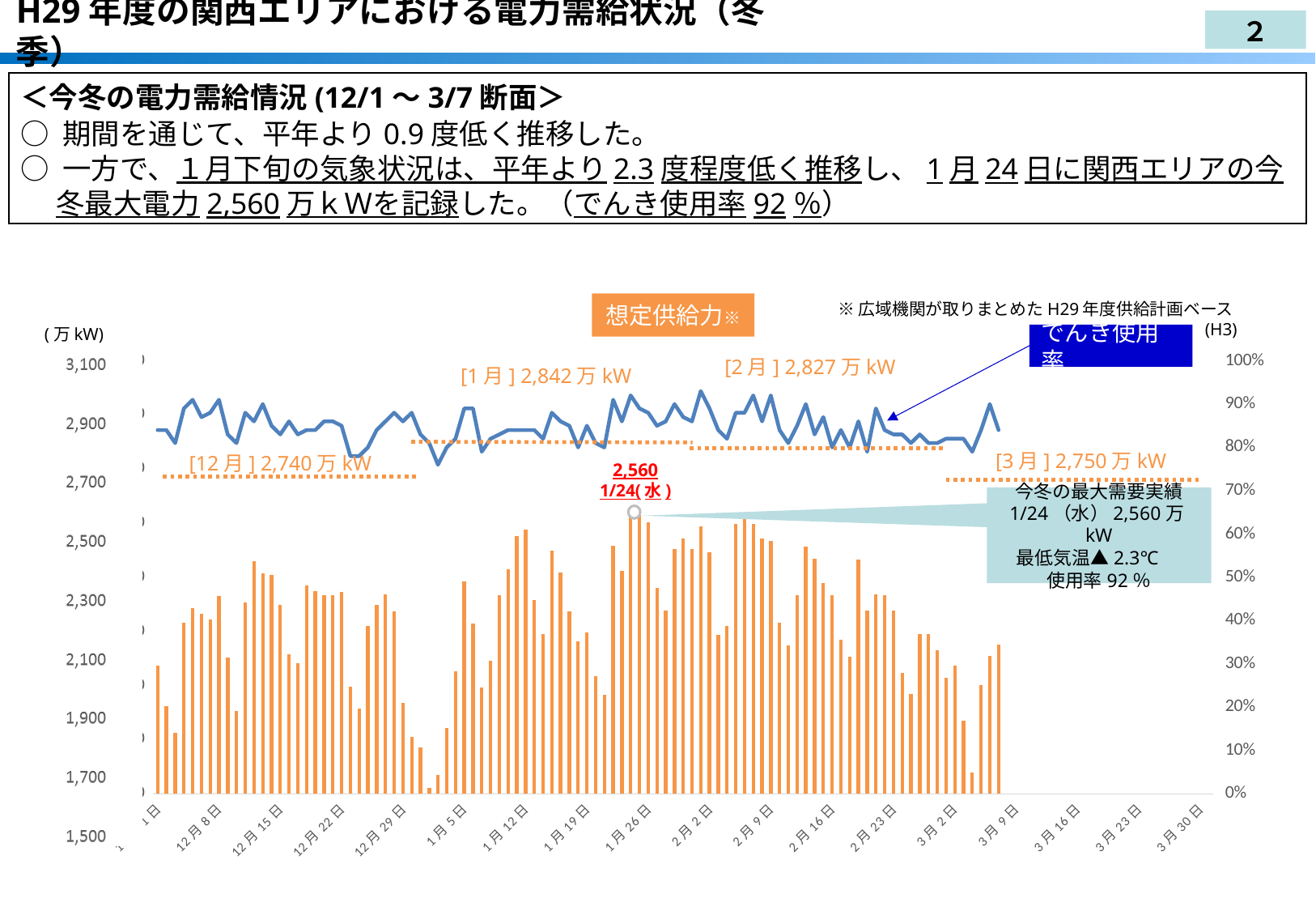
What is the difference between the 想定供給力 for March and December? 10万kW What is the 想定供給力 (assumed supply capacity) shown for January (1月)? 2,842万kW What is the 想定供給力 shown for December (12月)? 2,740万kW What is the maximum demand value labelled on the chart, and on what date did it occur? 2,560万kW on 1/24(水) Which month has the highest 想定供給力 on the chart? 1月 What kind of chart is shown on the slide? Combined bar and line chart Which month has the lowest 想定供給力 on the chart? 12月 What was the でんき使用率 (electricity usage rate) on the peak demand day 1/24? 92% What is the 想定供給力 shown for March (3月)? 2,750万kW Which is larger, the 想定供給力 for February or for March? 2月 What is the 想定供給力 shown for February (2月)? 2,827万kW What is the difference between the 想定供給力 for January and February? 15万kW